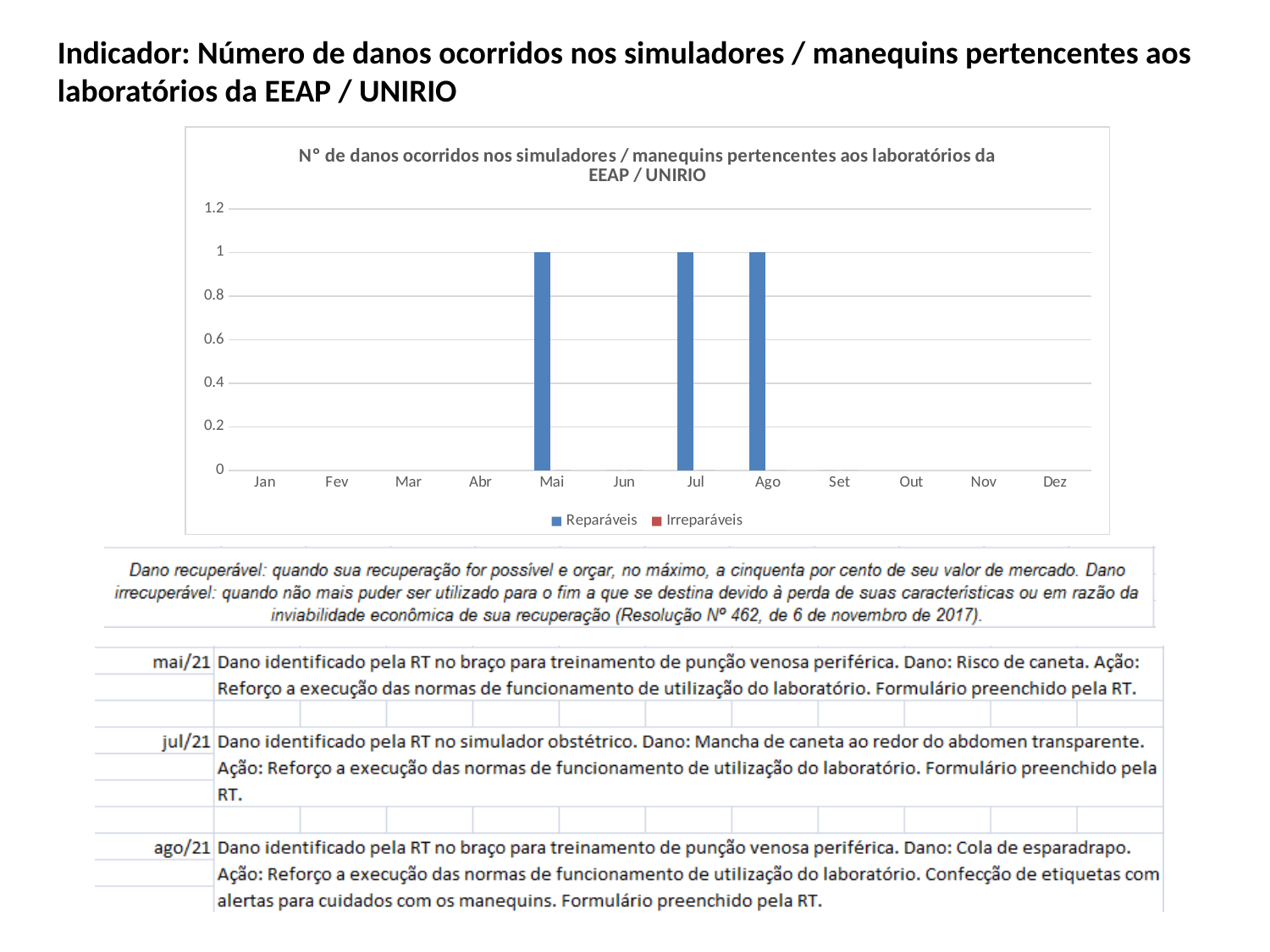
What are the two series named in the chart legend? Reparáveis and Irreparáveis What is the highest value shown on the chart's y axis? 1.2 How many months are shown along the x axis of the chart? 12 What is the difference between the Reparáveis value for Mai and the Reparáveis value for Jul? 0 What is the value of Reparáveis for Jul? 1 In how many months does the chart show a Reparáveis bar? 3 What kind of chart is shown on the slide? bar chart Is the value for Reparáveis in Mai greater or less than 0.8? greater What is the value of Reparáveis for Ago? 1 Which is larger, the Reparáveis value for Jul or the Reparáveis value for Jun? Jul What is the value of Reparáveis for Mai? 1 How many series does the chart legend list? 2